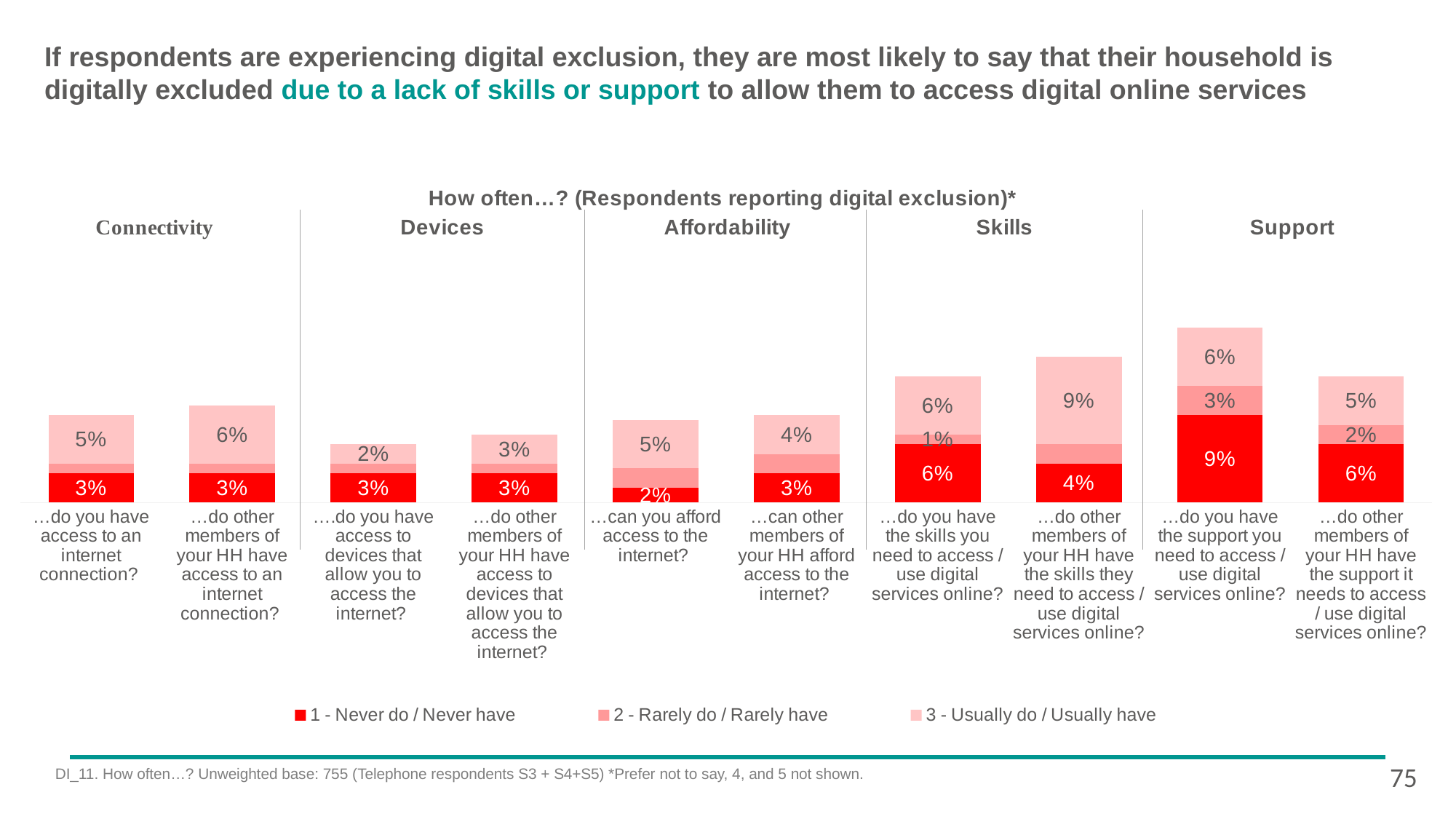
What is the value for "1 - Never do / Never have" for "…do you have the support you need to access / use digital services online?"? 9% What is the difference in the "1 - Never do / Never have" value between "…do you have the support you need to access / use digital services online?" and "…do other members of your HH have the support it needs to access / use digital services online?"? 3 percentage points What is the value for "3 - Usually do / Usually have" for "…do other members of your HH have the skills they need to access / use digital services online?"? 9% Which question has the highest "1 - Never do / Never have" value? …do you have the support you need to access / use digital services online? Which question has the tallest stacked bar overall? …do you have the support you need to access / use digital services online? Which has the larger "3 - Usually do / Usually have" value: "…do other members of your HH have the skills they need to access / use digital services online?" or "…do other members of your HH have access to an internet connection?"? …do other members of your HH have the skills they need to access / use digital services online? Which question has the lowest "1 - Never do / Never have" value? …can you afford access to the internet? What type of chart is shown on the slide? Stacked bar chart What is the total of the stacked bar for "…do you have the support you need to access / use digital services online?"? 18% How many series does the chart legend list? 3 How many questions (categories) are shown on the x axis of the chart? 10 What is the value for "2 - Rarely do / Rarely have" for "…do you have the skills you need to access / use digital services online?"? 1%